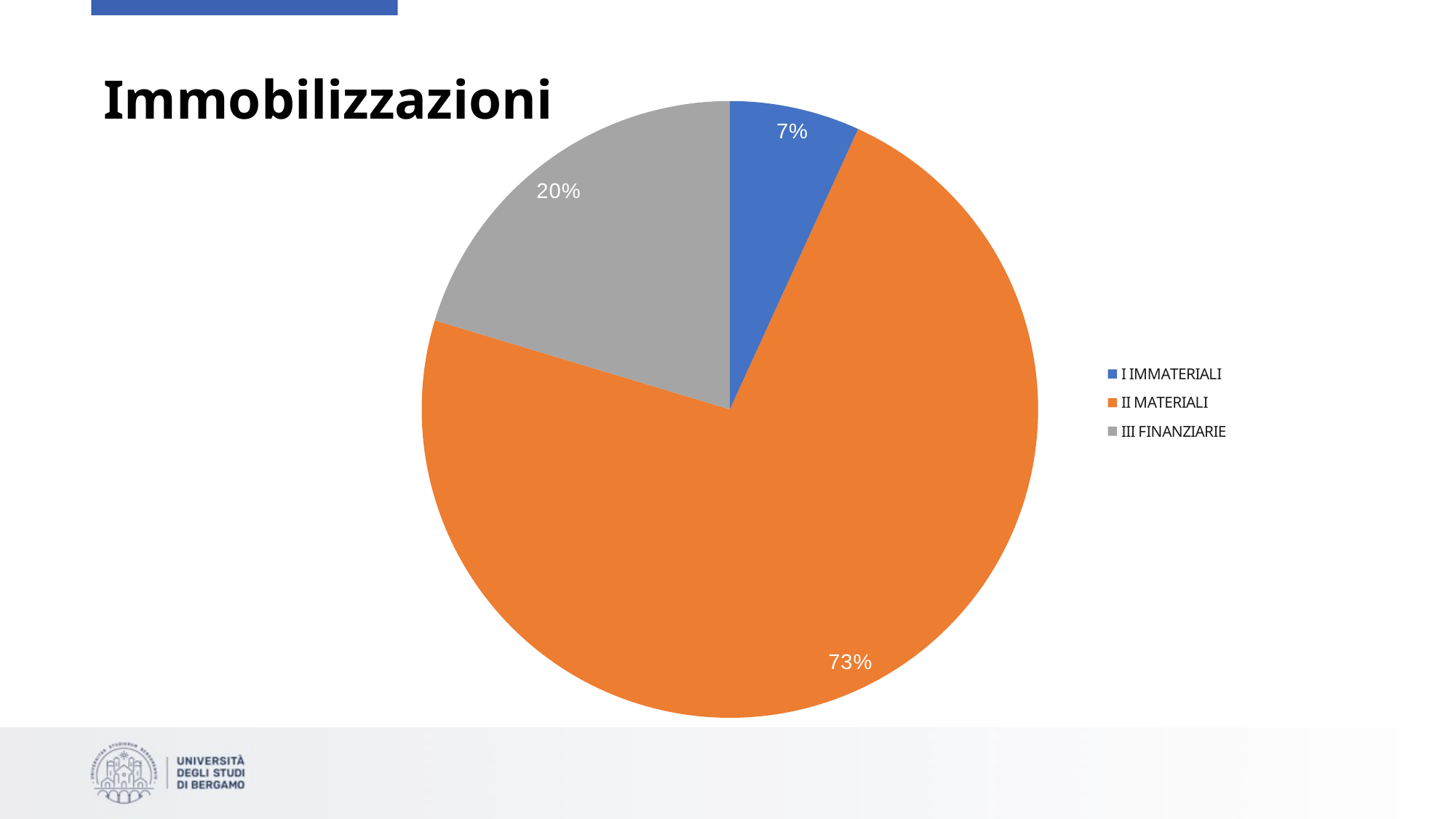
Which is larger, the share for III FINANZIARIE or the share for I IMMATERIALI? III FINANZIARIE Which category has the smallest slice of the pie? I IMMATERIALI What kind of chart is shown on the slide? Pie chart What colour is the slice for III FINANZIARIE? Grey What share of the pie does I IMMATERIALI represent? 7% Which category has the largest slice of the pie? II MATERIALI What is the difference in percentage points between III FINANZIARIE and I IMMATERIALI? 13 What share of the pie does III FINANZIARIE represent? 20% What is the title of the slide containing the chart? Immobilizzazioni What share of the pie does II MATERIALI represent? 73% How many categories are shown in the pie chart? 3 What is the difference in percentage points between II MATERIALI and III FINANZIARIE? 53